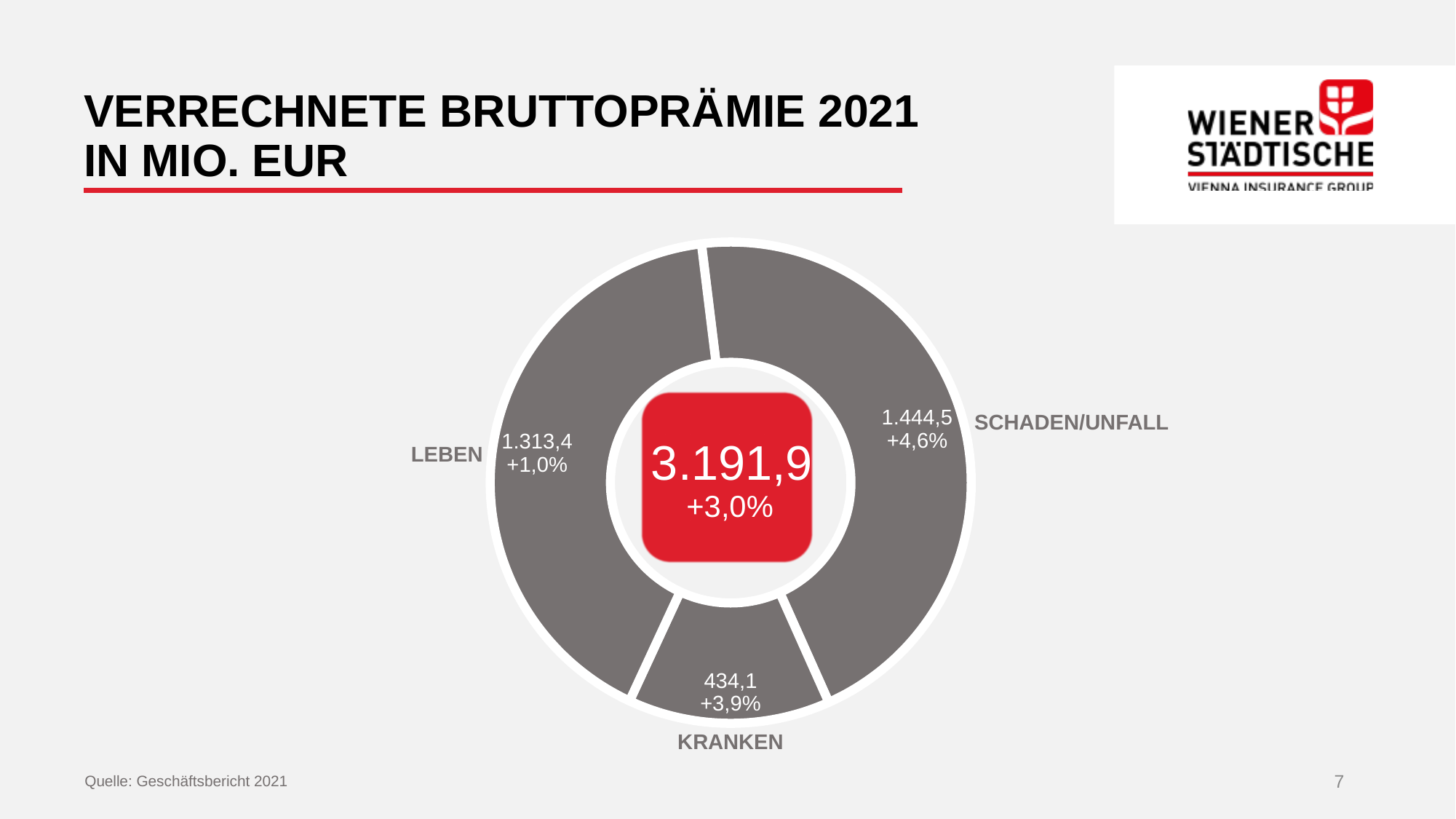
What is the value shown for LEBEN? 1.313,4 What total value is shown in the centre of the chart? 3.191,9 What is the difference between the values for SCHADEN/UNFALL and LEBEN? 131,1 What is the value shown for SCHADEN/UNFALL? 1.444,5 What growth rate is shown for SCHADEN/UNFALL? +4,6% What kind of chart is shown on the slide? doughnut chart Which segment has the lowest value? KRANKEN What growth rate is shown for KRANKEN? +3,9% Which segment has the highest value? SCHADEN/UNFALL How many segments does the chart have? 3 What growth rate is shown for the total in the centre of the chart? +3,0% What is the value shown for KRANKEN? 434,1